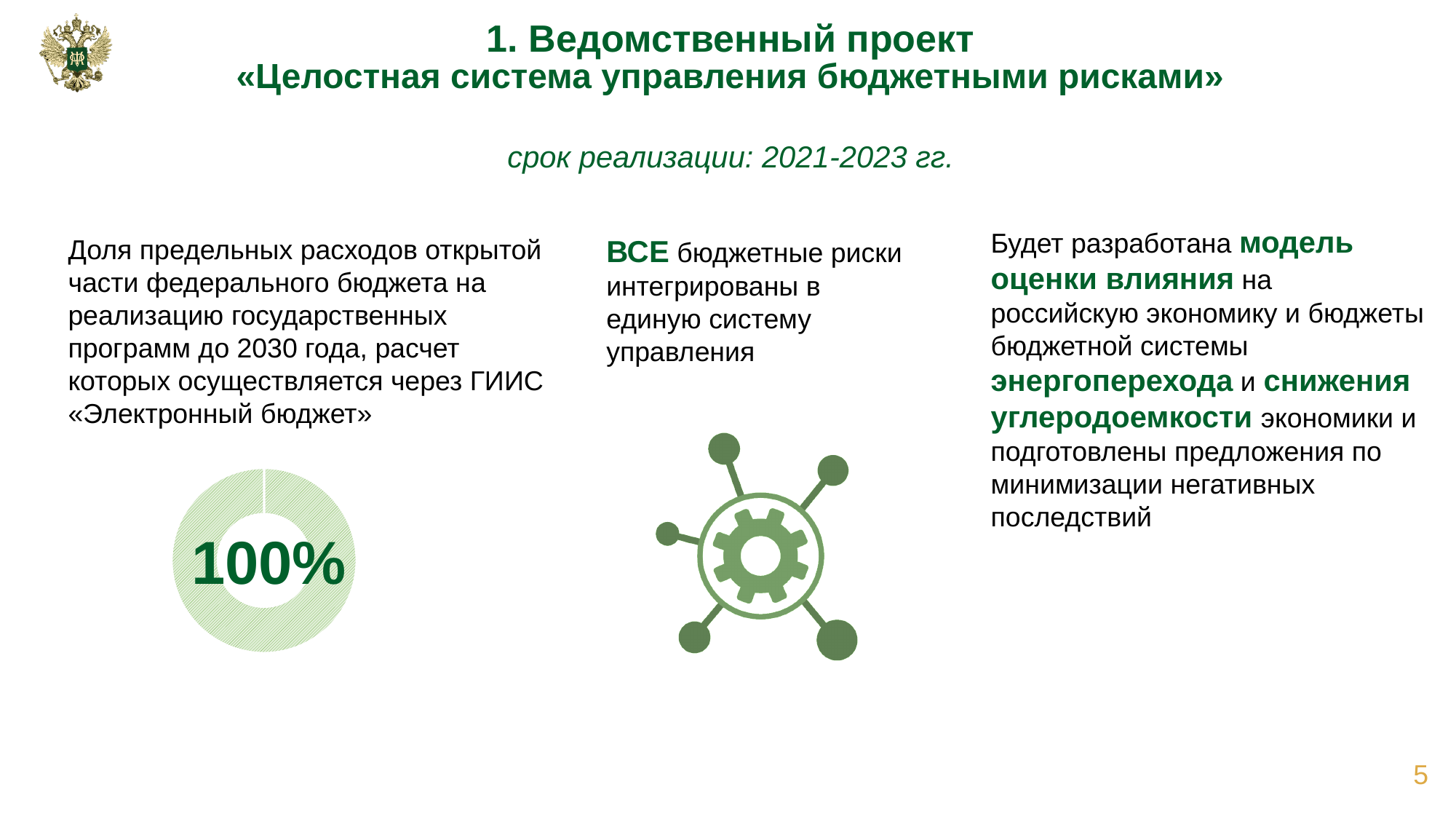
What colour is the doughnut chart's ring? green How many slices does the doughnut chart contain? 1 Which indicator does the doughnut chart illustrate, according to the text above it? Доля предельных расходов открытой части федерального бюджета на реализацию государственных программ до 2030 года What kind of chart is shown on the slide? doughnut chart What share of the doughnut chart does the single filled slice occupy? 100% What value is printed in the centre of the doughnut chart? 100%